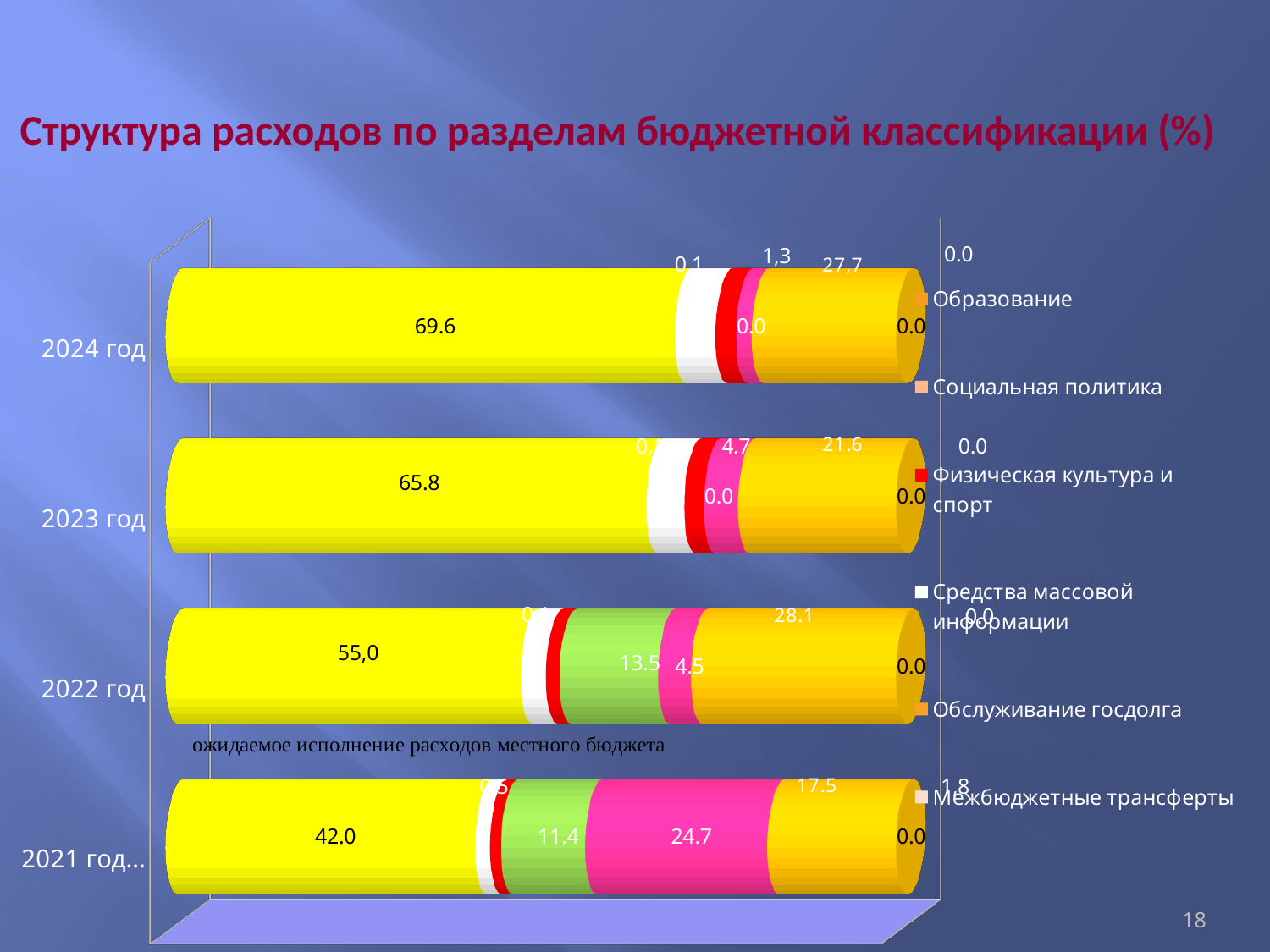
How many years (bars) are shown in the chart? 4 What is the value of the largest (yellow) segment of the 2022 год bar? 55,0 What is the value of the largest (yellow) segment of the 2023 год bar? 65.8 Which year has the lowest value for the yellow segment? 2021 год Is the yellow segment value larger for 2024 год or for 2023 год? 2024 год What is the value of the green segment of the 2021 год bar? 11.4 What is the difference between the yellow segment values for 2024 год and 2021 год? 27.6 Which year has the highest value for the yellow segment? 2024 год What is the value of the largest (yellow) segment of the 2024 год bar? 69.6 Does the value of the yellow segment increase or decrease from 2021 год to 2024 год? increase What is the value of the largest (yellow) segment of the 2021 год bar? 42.0 What kind of chart is shown on the slide? bar chart